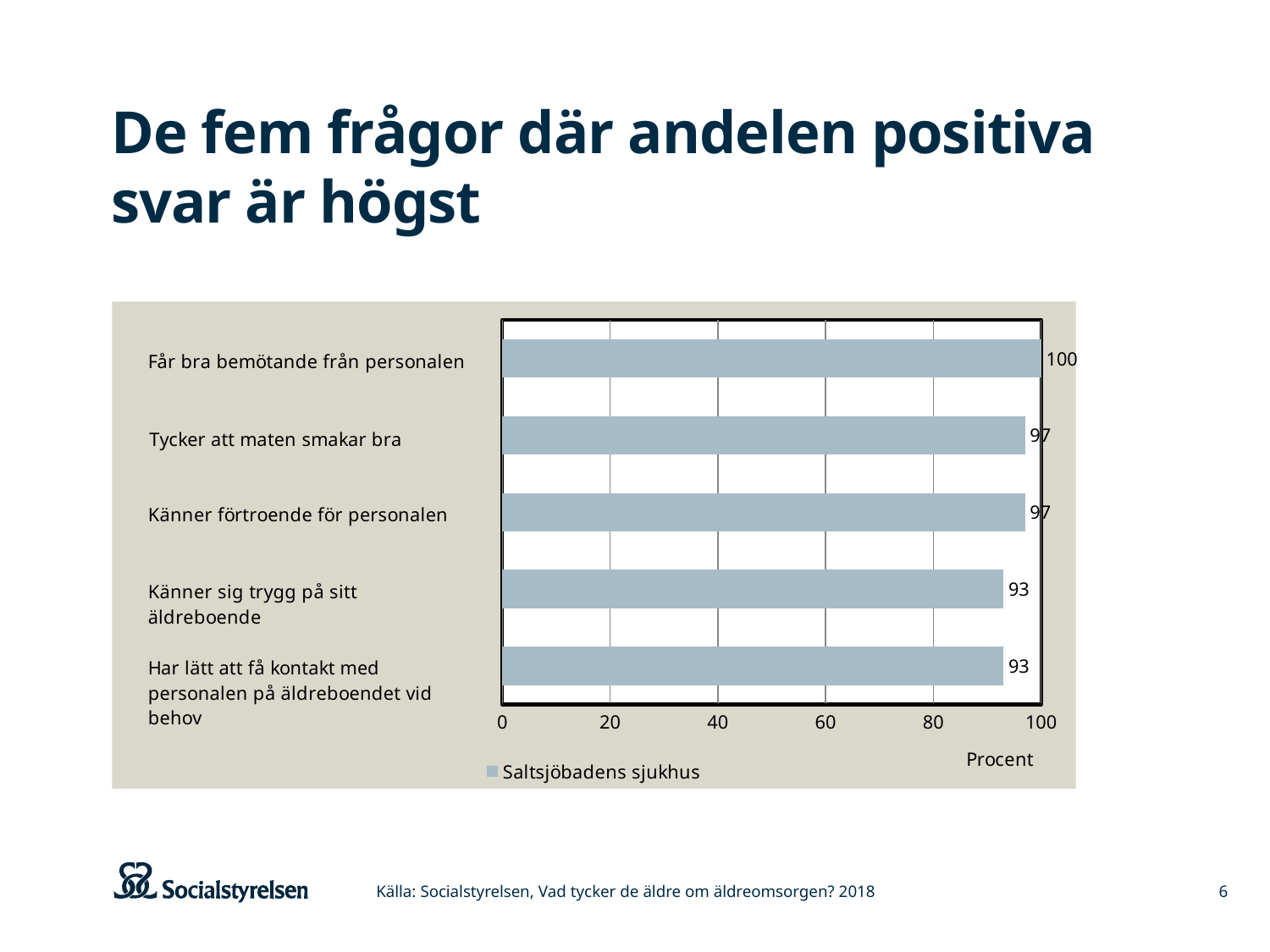
What is the difference between the values for "Tycker att maten smakar bra" and "Känner sig trygg på sitt äldreboende"? 4 Which is larger, the value for "Får bra bemötande från personalen" or the value for "Har lätt att få kontakt med personalen på äldreboendet vid behov"? Får bra bemötande från personalen What is the value for "Får bra bemötande från personalen"? 100 What is the value for "Tycker att maten smakar bra"? 97 Which category has the highest value? Får bra bemötande från personalen How many series does the legend list? 1 What kind of chart is shown on the slide? Bar chart What is the difference between the values for "Får bra bemötande från personalen" and "Känner förtroende för personalen"? 3 What is the value for "Känner sig trygg på sitt äldreboende"? 93 How many categories are shown in the chart? 5 What is the value for "Har lätt att få kontakt med personalen på äldreboendet vid behov"? 93 What series name is shown in the chart legend? Saltsjöbadens sjukhus